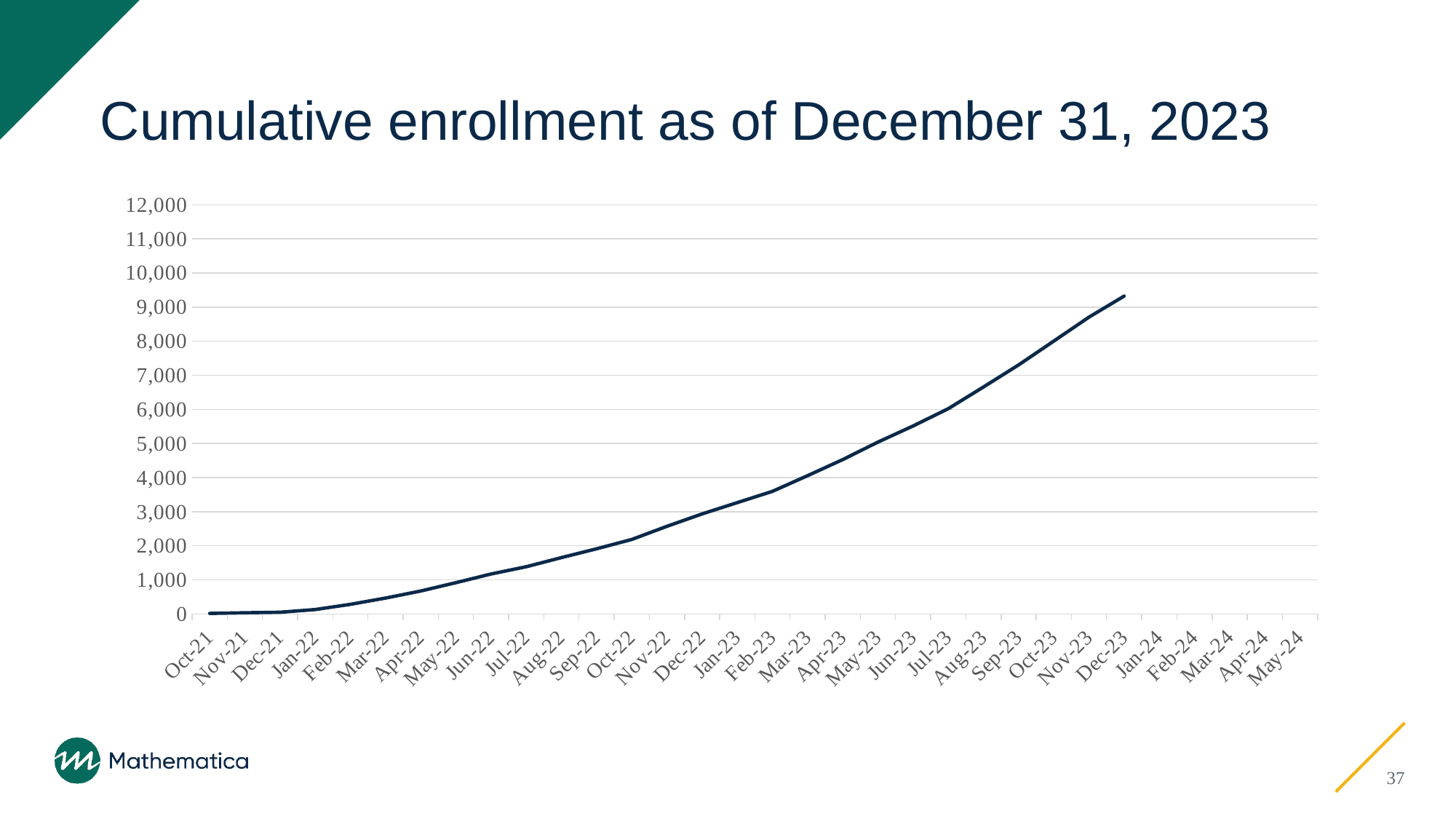
What is the highest value shown on the y axis? 12,000 Which is larger, the value for Jun-23 or the value for Jun-22? Jun-23 Is the value for Nov-23 greater or less than 8,000? greater What is the title of the chart? Cumulative enrollment as of December 31, 2023 Which month has the lowest cumulative enrollment? Oct-21 What kind of chart is shown on the slide? Line chart Is the value for Jan-22 greater or less than 1,000? less Is the value for Dec-23 greater or less than 10,000? less Does cumulative enrollment rise or fall from Oct-21 to Dec-23? Rise Which month has the highest cumulative enrollment? Dec-23